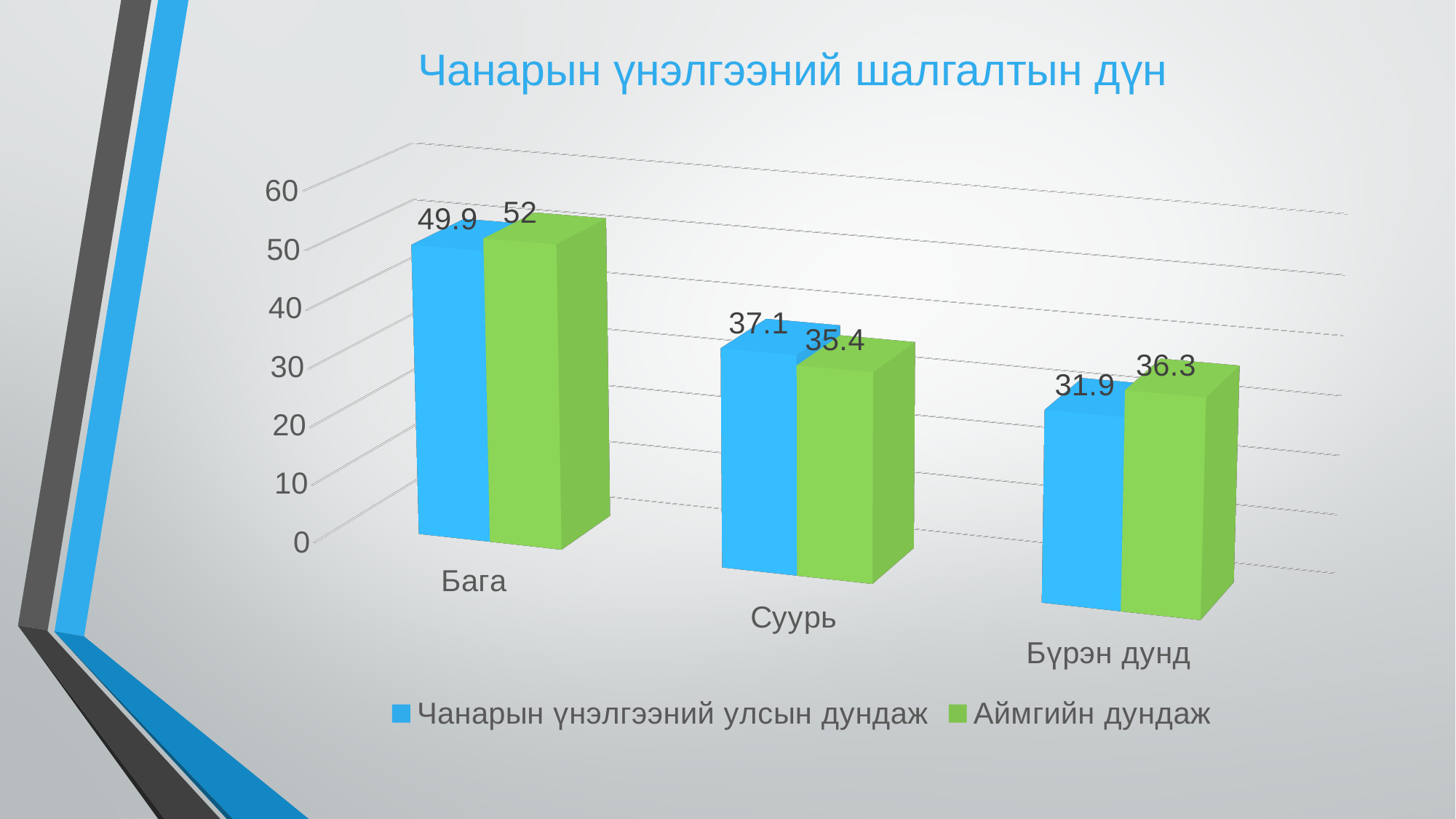
What is the difference between the Аймгийн дундаж and Чанарын үнэлгээний улсын дундаж values for Бүрэн дунд? 4.4 What is the value for Бага in the Аймгийн дундаж series? 52 For Суурь, which series has the larger value: Чанарын үнэлгээний улсын дундаж or Аймгийн дундаж? Чанарын үнэлгээний улсын дундаж What is the value for Бага in the Чанарын үнэлгээний улсын дундаж series? 49.9 Which category has the highest value in the Аймгийн дундаж series? Бага How many categories are shown on the x axis? 3 How many series does the legend list? 2 Which category has the lowest value in the Чанарын үнэлгээний улсын дундаж series? Бүрэн дунд What is the title of the chart? Чанарын үнэлгээний шалгалтын дүн What is the value for Бүрэн дунд in the Аймгийн дундаж series? 36.3 What is the value for Суурь in the Чанарын үнэлгээний улсын дундаж series? 37.1 What kind of chart is shown on the slide? Bar chart